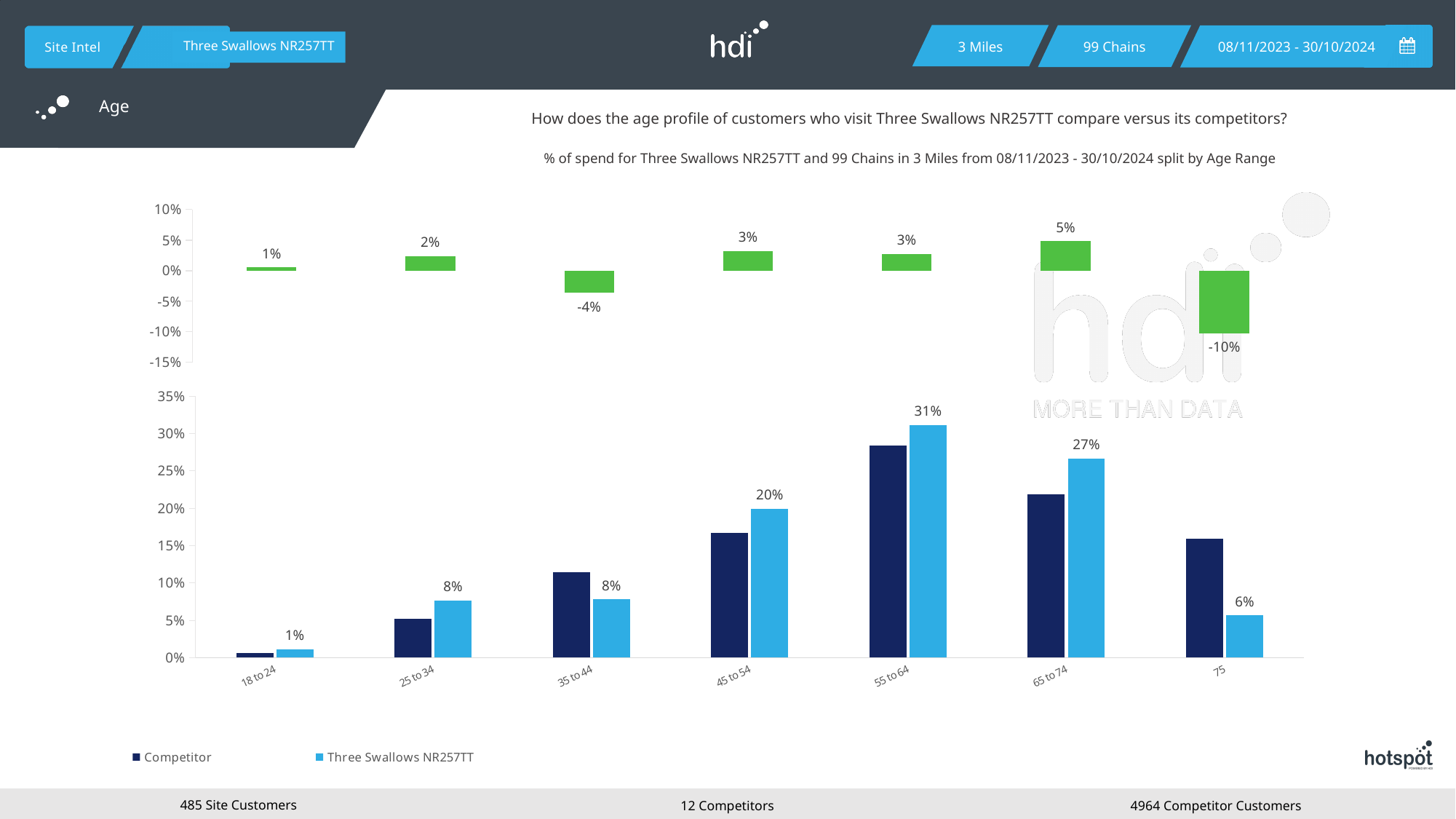
In the bottom chart, what is the difference between the Three Swallows NR257TT values for 55 to 64 and 65 to 74? 4% In the bottom chart, which age range has the highest value for Three Swallows NR257TT? 55 to 64 In the bottom chart, is the Competitor value for 45 to 54 greater or less than 20%? less In the bottom chart, what is the value for Three Swallows NR257TT in the 45 to 54 age range? 20% How many series does the legend of the bottom chart list? 2 In the bottom chart, which is larger for the 75 age range: the Competitor bar or the Three Swallows NR257TT bar? Competitor How many age range categories are shown on the x axis of the bottom chart? 7 In the top chart, what is the value shown for the 75 age range? -10% In the top chart, which age range has the lowest value? 75 In the bottom chart, is the Competitor value for 55 to 64 greater or less than 25%? greater In the top chart, what is the value shown for the 35 to 44 age range? -4% In the bottom chart, what is the value for Three Swallows NR257TT in the 55 to 64 age range? 31%